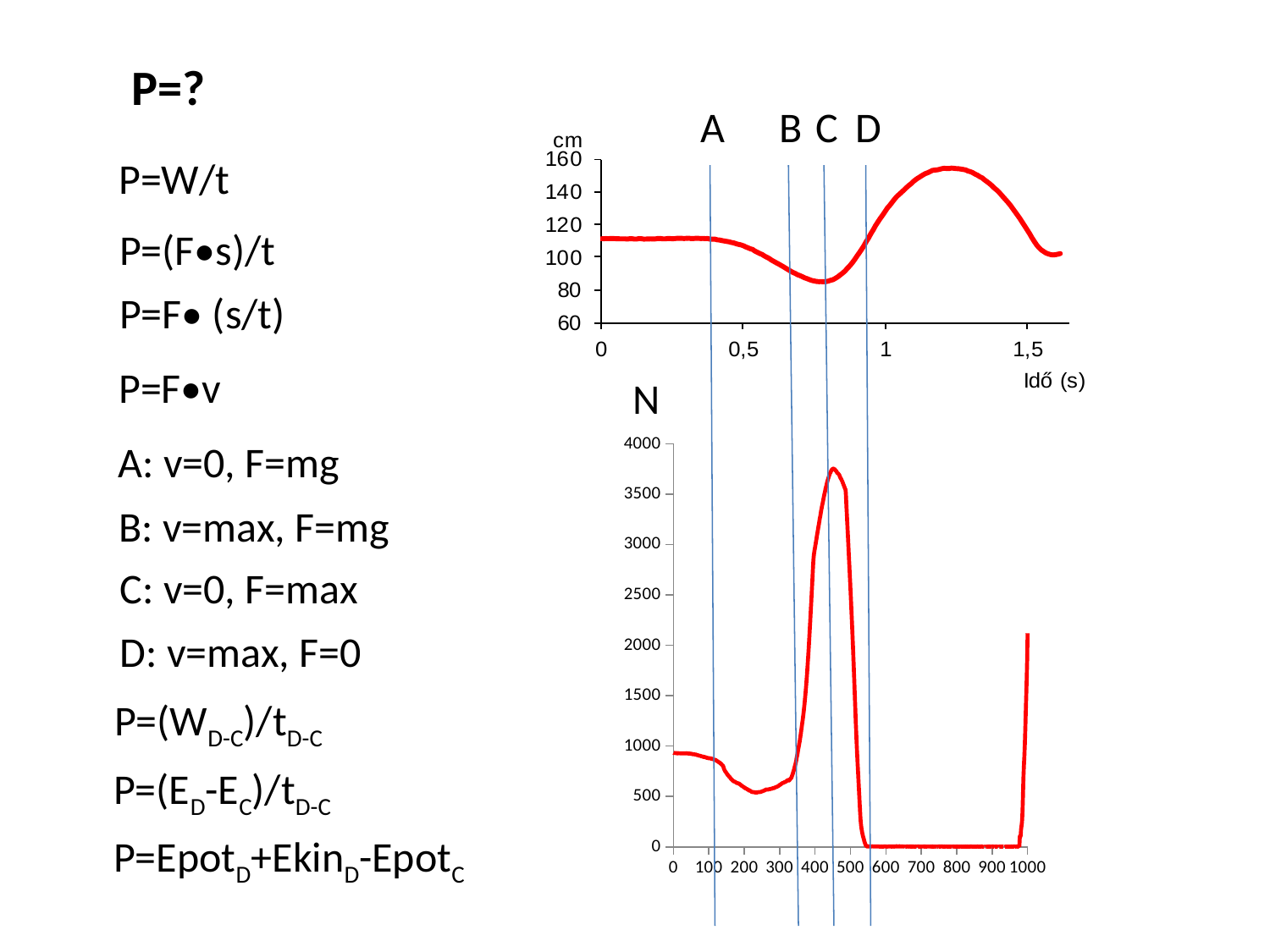
In the top chart, does the curve rise or fall between the line marked C and the line marked D? rises What kind of chart is the bottom chart (with the N axis)? line chart What kind of chart is the top chart (with the cm axis)? line chart In the bottom chart, is the peak of the curve greater or less than 3500? greater In the bottom chart, is the value at x = 0 greater or less than 500? greater In the top chart, does the curve rise or fall between the lines marked A and C? falls In the bottom chart, is the value at x = 700 greater or less than 500? less In the top chart, what is the label of the horizontal axis? Idő (s) In the top chart, what unit is written at the top of the vertical axis? cm